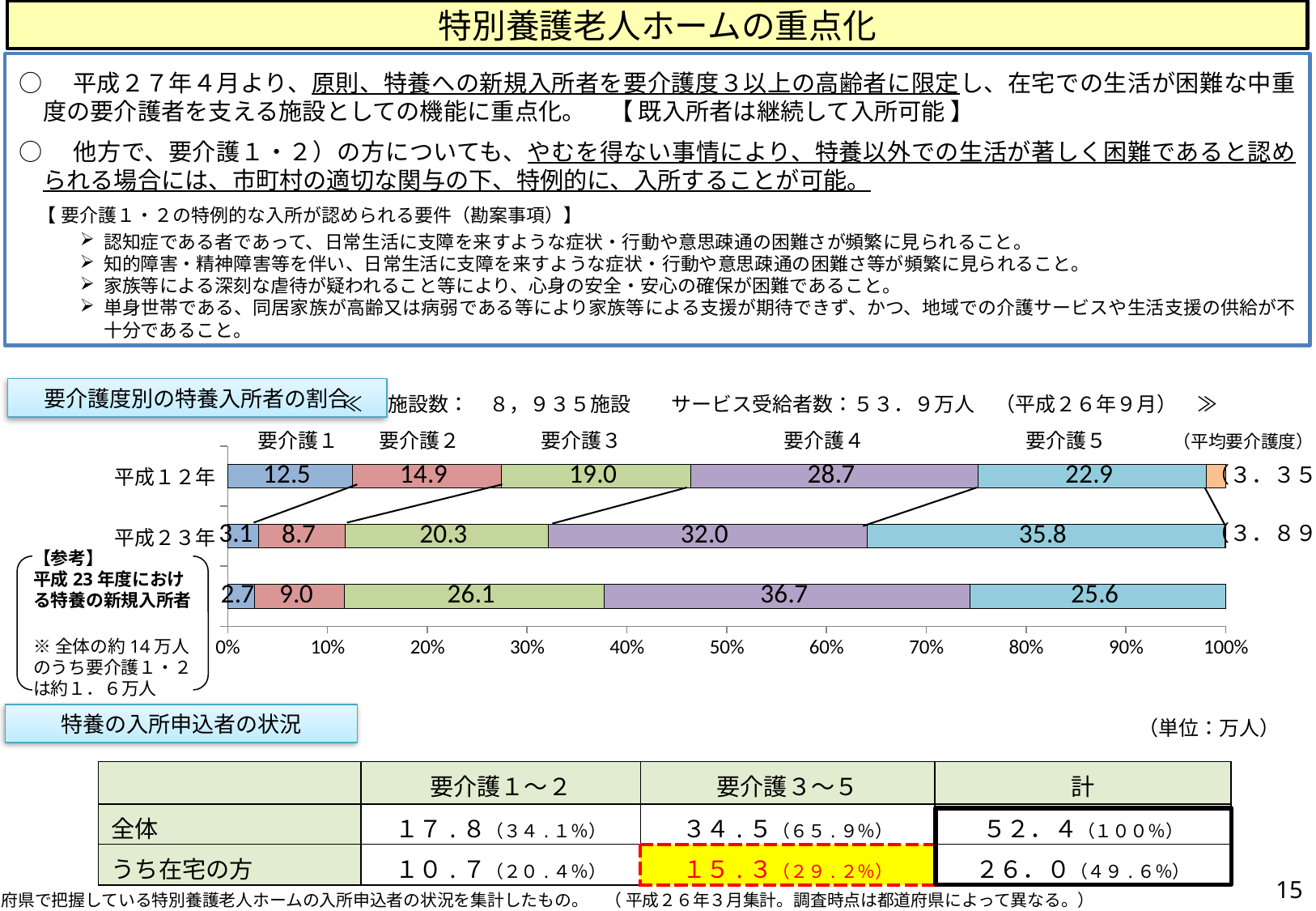
In the stacked bar chart 要介護度別の特養入所者の割合, what is the value for 要介護4 in the 平成12年 bar? 28.7 In the stacked bar chart 要介護度別の特養入所者の割合, what is the difference between the 要介護5 values for 平成23年 and 平成12年? 12.9 In the stacked bar chart 要介護度別の特養入所者の割合, what is the 平均要介護度 shown for 平成23年? 3.89 In the stacked bar chart 要介護度別の特養入所者の割合, which is larger: 要介護4 in 平成23年 or 要介護4 in the bottom bar (新規入所者)? 要介護4 in the bottom bar (新規入所者), 36.7 In the stacked bar chart 要介護度別の特養入所者の割合, what is the value for 要介護3 in the bottom bar (平成23年度における特養の新規入所者)? 26.1 In the stacked bar chart 要介護度別の特養入所者の割合, how many care-level series are labelled above the chart? 5 In the stacked bar chart 要介護度別の特養入所者の割合, which care level has the smallest segment in the 平成12年 bar? 要介護1 In the stacked bar chart 要介護度別の特養入所者の割合, what is the value for 要介護1 in the 平成23年 bar? 3.1 In the stacked bar chart 要介護度別の特養入所者の割合, how many bars are plotted? 3 In the stacked bar chart 要介護度別の特養入所者の割合, which care level has the largest segment in the 平成23年 bar? 要介護5 In the stacked bar chart 要介護度別の特養入所者の割合, what is the value for 要介護5 in the 平成23年 bar? 35.8 What kind of chart is 要介護度別の特養入所者の割合? Stacked horizontal bar chart